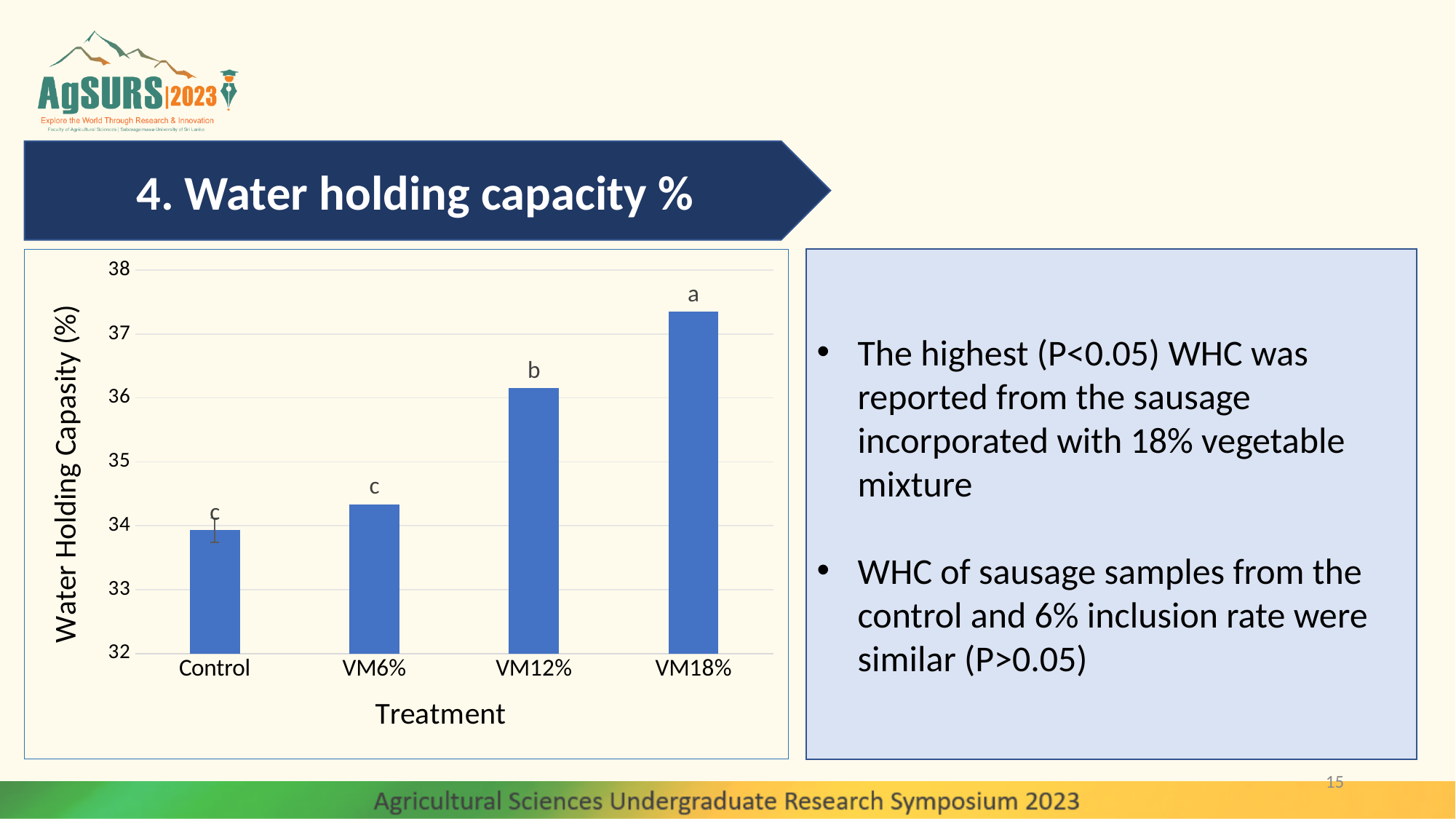
What kind of chart is shown on the slide? bar chart Which has a higher water holding capacity, VM12% or VM6%? VM12% Is the value for VM12% greater or less than 36? greater What is the title of the y axis? Water Holding Capasity (%) How many treatment categories are plotted on the x axis? 4 Do the values rise or fall from Control to VM18% along the x axis? rise Which treatment has the highest water holding capacity? VM18% Is the value for VM6% greater or less than 35? less Which treatment has the lowest water holding capacity? Control What letter is printed above the VM12% bar? b Is the value for VM18% greater or less than 37? greater